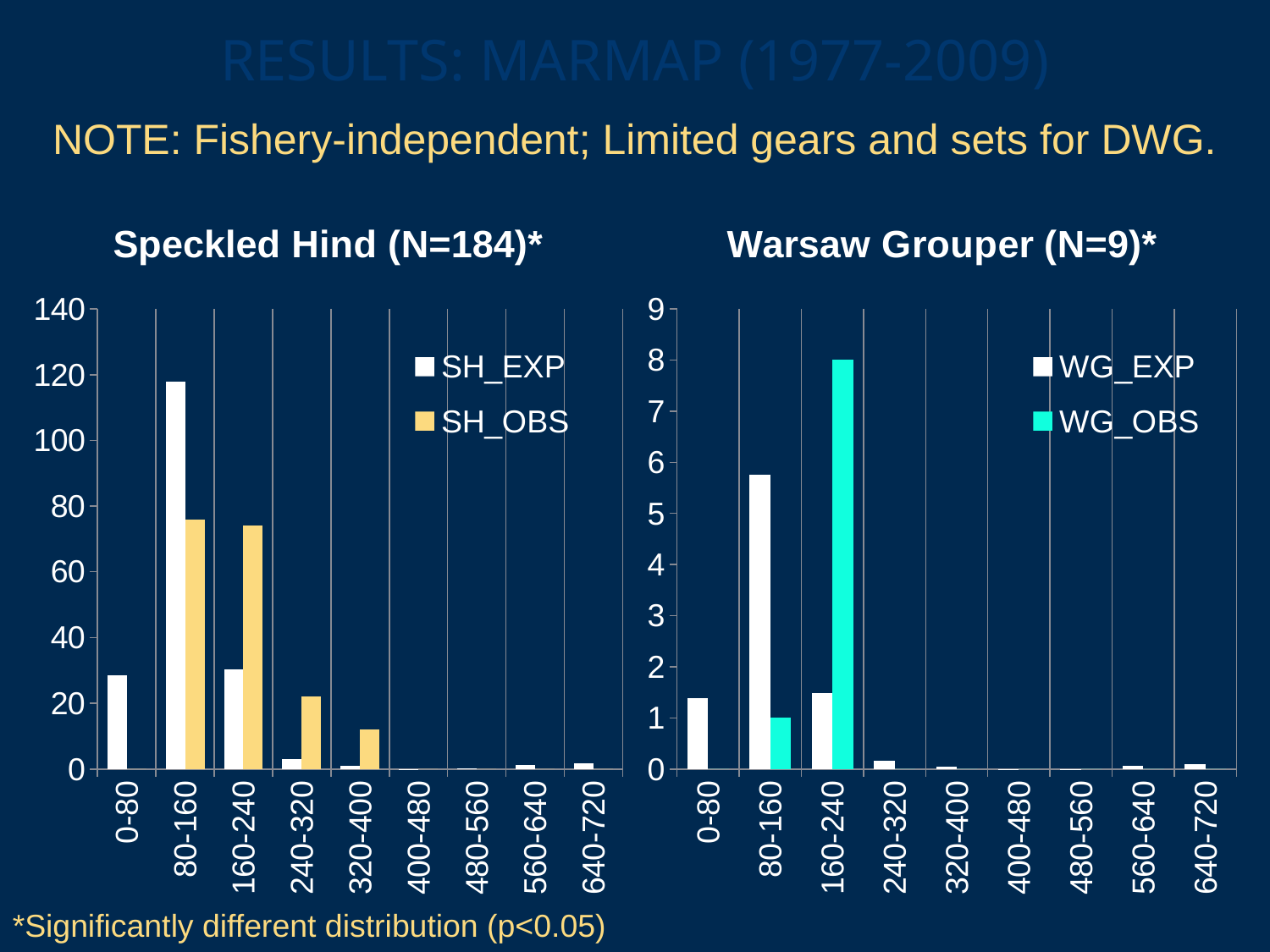
In the Warsaw Grouper (N=9)* chart, which category has the highest WG_OBS value? 160-240 In the Warsaw Grouper (N=9)* chart, which is larger for 160-240: WG_EXP or WG_OBS? WG_OBS How many size categories are shown on the x axis of the Speckled Hind (N=184)* chart? 9 What are the two legend entries in the Speckled Hind (N=184)* chart? SH_EXP and SH_OBS In the Speckled Hind (N=184)* chart, which category has the highest SH_EXP value? 80-160 What kind of chart is the Speckled Hind (N=184)* chart? Bar chart In the Speckled Hind (N=184)* chart, is the SH_EXP value for 80-160 greater or less than 100? greater In the Speckled Hind (N=184)* chart, which is larger for 80-160: SH_EXP or SH_OBS? SH_EXP How many series does the legend of the Warsaw Grouper (N=9)* chart list? 2 In the Warsaw Grouper (N=9)* chart, what is the WG_OBS value for 160-240? 8 In the Warsaw Grouper (N=9)* chart, what is the WG_OBS value for 80-160? 1 In the Speckled Hind (N=184)* chart, is the SH_OBS value for 240-320 greater or less than 40? less